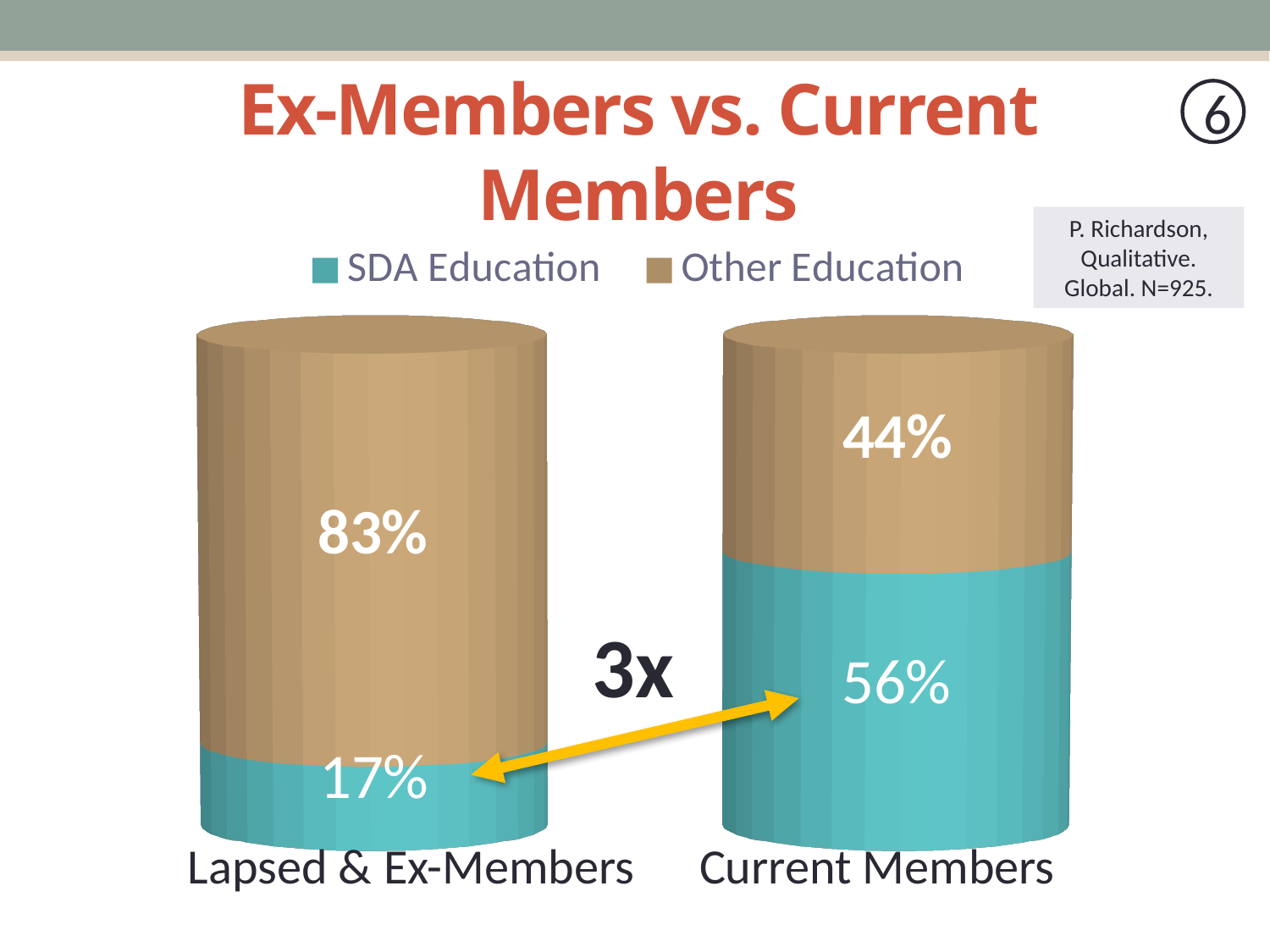
What is the Other Education value for Lapsed & Ex-Members? 83% Which category has the higher SDA Education value? Current Members What kind of chart is shown on the slide? Stacked bar chart Which category has the lower Other Education value? Current Members What is the SDA Education value for Current Members? 56% How many categories are shown on the x axis? 2 What is the difference between the SDA Education values for Current Members and Lapsed & Ex-Members? 39% What is the SDA Education value for Lapsed & Ex-Members? 17% How many series does the legend list? 2 What is the Other Education value for Current Members? 44% What is the title of the chart? Ex-Members vs. Current Members Is the Other Education value larger for Lapsed & Ex-Members or for Current Members? Lapsed & Ex-Members